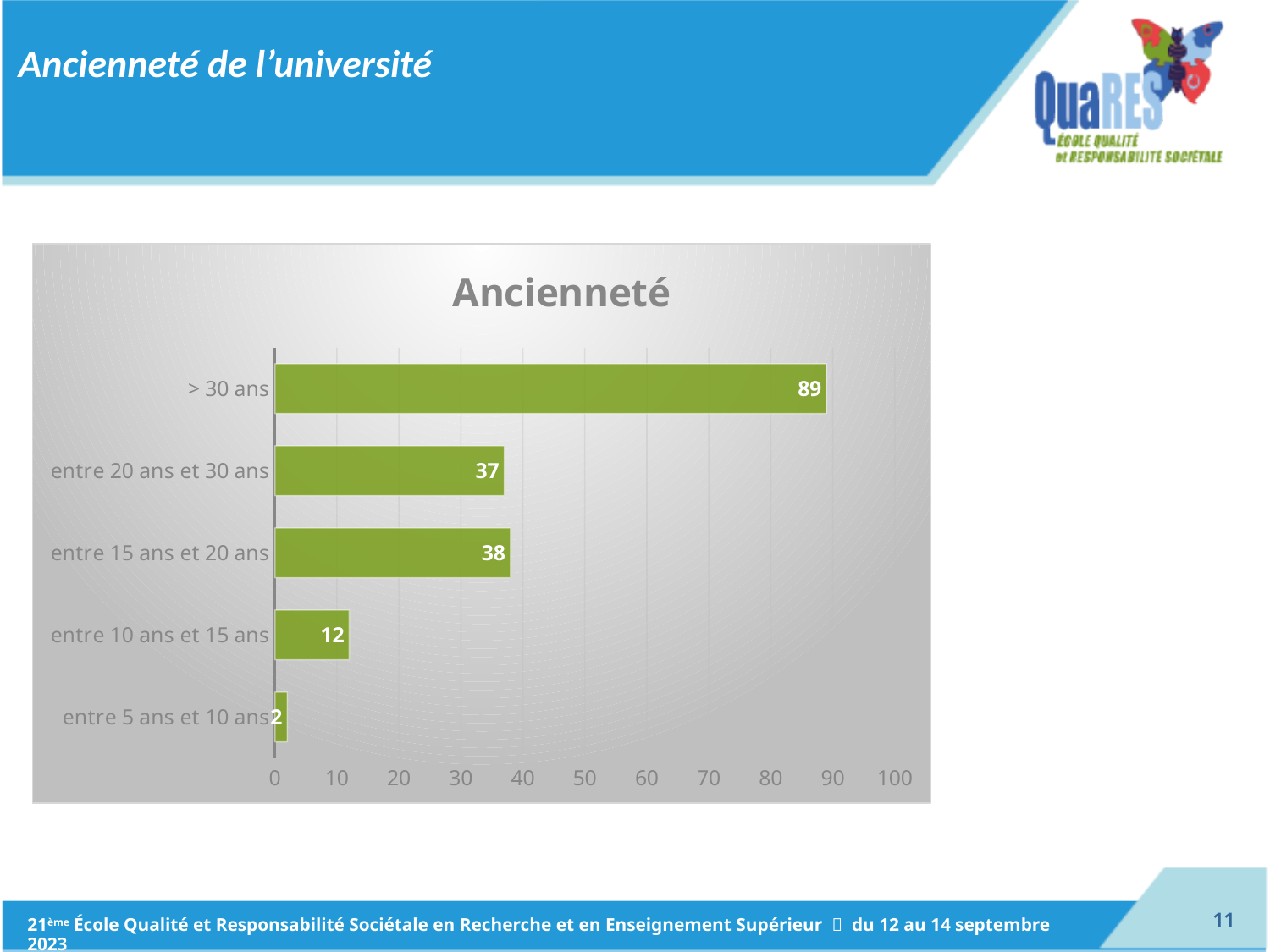
What is the title of the chart? Ancienneté Which category has the lowest value? entre 5 ans et 10 ans What kind of chart is shown on the slide? bar chart Which is larger: the value for "entre 10 ans et 15 ans" or the value for "entre 5 ans et 10 ans"? entre 10 ans et 15 ans What is the value for "entre 10 ans et 15 ans"? 12 How many categories are shown in the chart? 5 What is the value for "entre 20 ans et 30 ans"? 37 What is the value for "> 30 ans"? 89 Which category has the highest value? > 30 ans What is the value for "entre 15 ans et 20 ans"? 38 What is the value for "entre 5 ans et 10 ans"? 2 What is the difference between the values for "> 30 ans" and "entre 20 ans et 30 ans"? 52